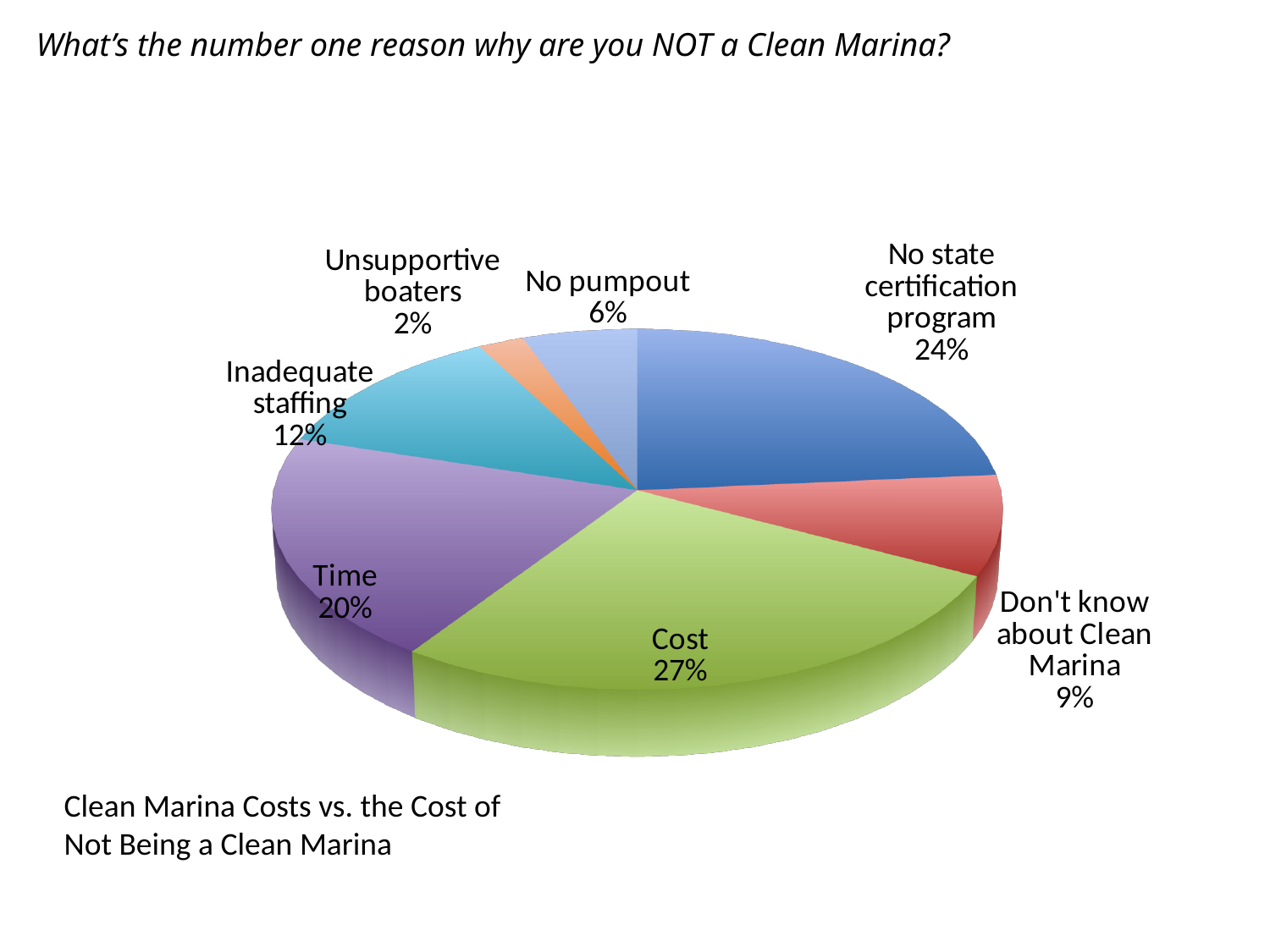
Which slice has the smallest share of the pie? Unsupportive boaters What is the difference in percentage points between Cost and Time? 7 Which is larger, the share for No pumpout or the share for Don't know about Clean Marina? Don't know about Clean Marina What percentage is shown for Time? 20% Which slice has the largest share of the pie? Cost What kind of chart is shown on the slide? pie chart What percentage is shown for Don't know about Clean Marina? 9% What share of the pie is labelled Cost? 27% How many slices does the pie chart have? 7 What percentage is shown for No state certification program? 24% What percentage is shown for Inadequate staffing? 12% What question is the pie chart answering, according to the slide title? What's the number one reason why are you NOT a Clean Marina?